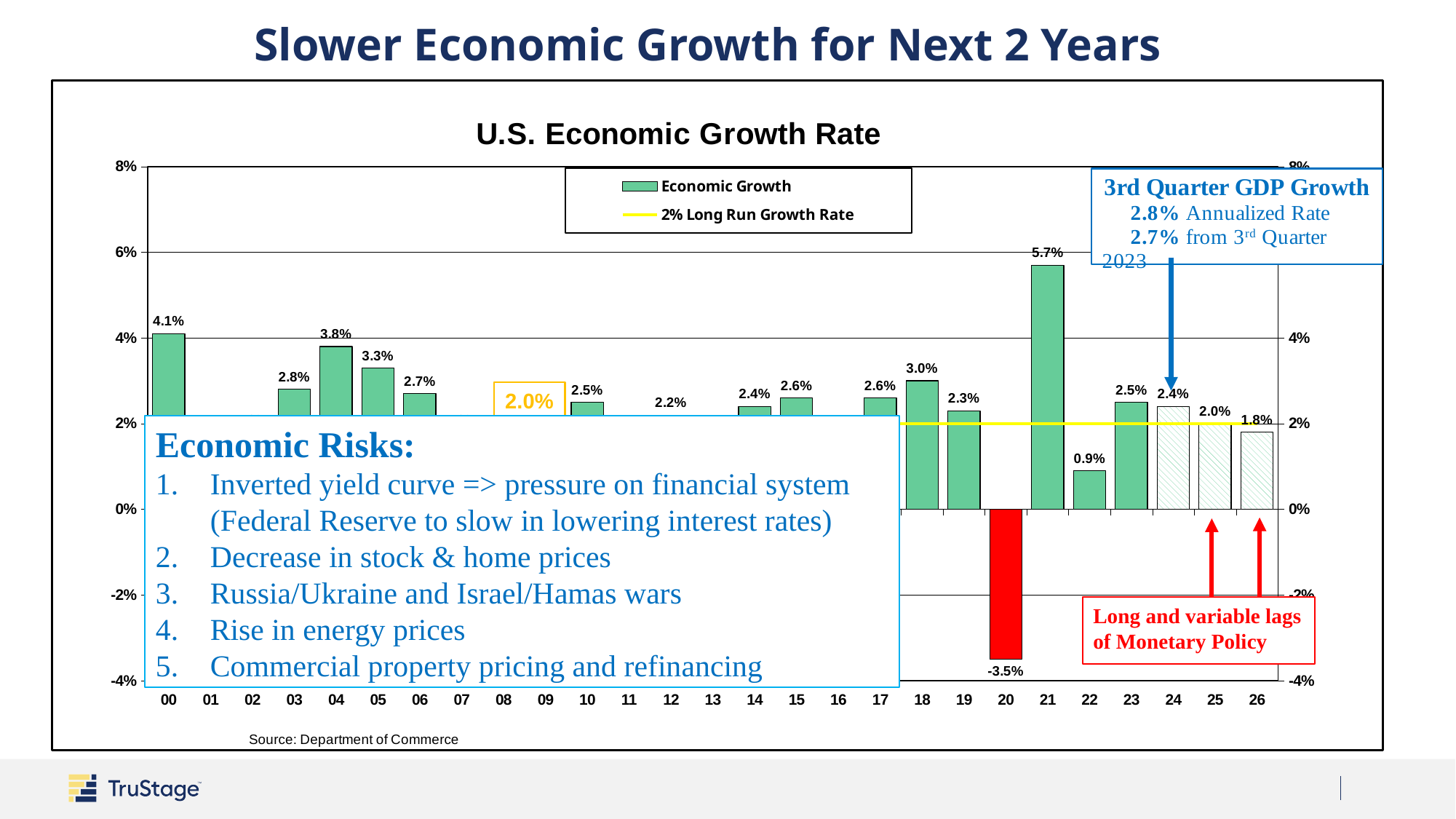
Which year has the lowest economic growth rate on the chart? 20 What is the economic growth rate shown for the year labelled 00? 4.1% Which year has the highest economic growth rate on the chart? 21 What is the difference between the growth rates shown for 24 and 26? 0.6 percentage points Which year has the higher growth rate, 04 or 05? 04 Do the growth rates rise or fall from 24 to 26? Fall What is the economic growth rate shown for 2020 (labelled 20)? -3.5% Is the growth rate for 22 greater or less than 2%? less How many entries does the chart legend list? 2 What is the U.S. economic growth rate shown for 2021 (labelled 21)? 5.7% What is the title of the chart? U.S. Economic Growth Rate What type of chart is used to show the U.S. Economic Growth Rate? Bar chart